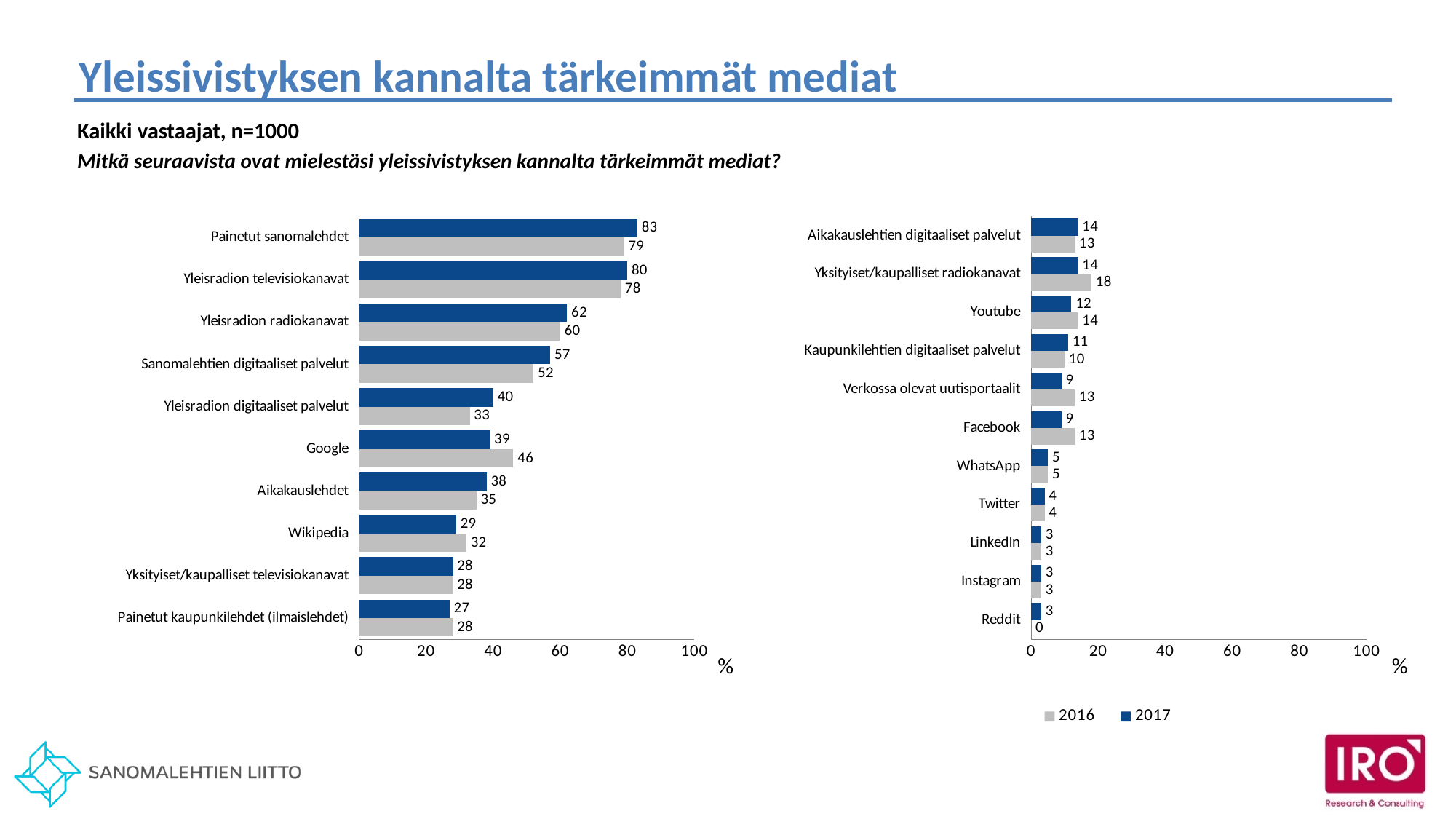
In the right chart, which is larger for Facebook: the 2016 value or the 2017 value? 2016 In the left chart, what is the difference between the 2017 and 2016 values for Yleisradion digitaaliset palvelut? 7 How many series does the legend list? 2 In the left chart, how many categories are shown? 10 In the right chart, what is the 2016 value for Yksityiset/kaupalliset radiokanavat? 18 In the right chart, what is the 2016 value for Reddit? 0 In the right chart, which category has the lowest 2016 value? Reddit In the left chart, which category has the highest 2017 value? Painetut sanomalehdet Which colour represents 2017 in the charts? Dark blue What type of chart is the left chart? Bar chart In the left chart, what is the 2016 value for Google? 46 In the left chart, what is the 2017 value for Painetut sanomalehdet? 83